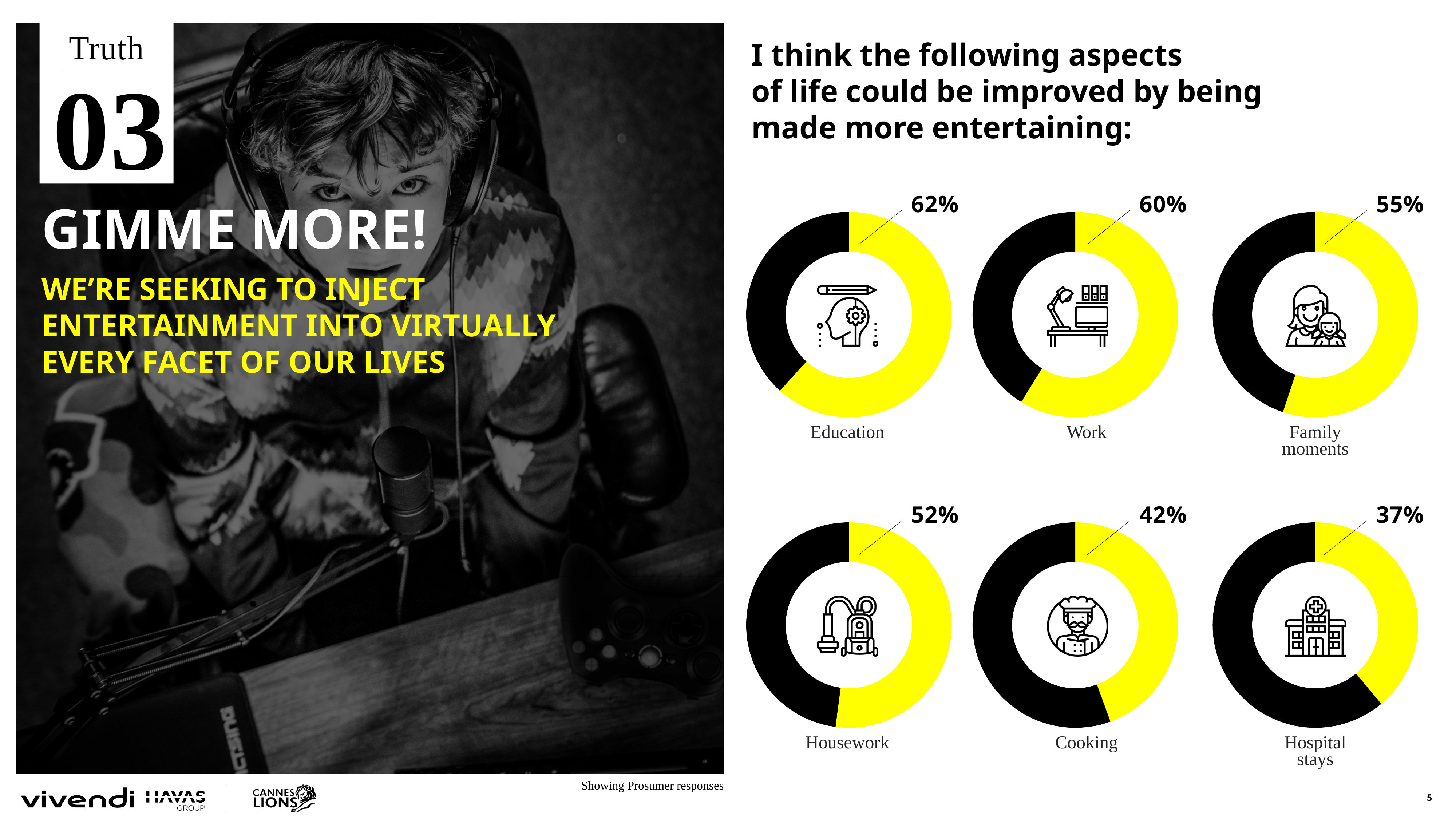
What percentage is shown for the Cooking donut chart? 42% What percentage is shown for the Work donut chart? 60% Which has a larger percentage, Housework or Cooking? Housework Which aspect of life has the highest percentage across the donut charts? Education How many donut charts are shown on the slide? 6 What is the difference between the Education percentage and the Hospital stays percentage? 25% Which aspect of life has the lowest percentage across the donut charts? Hospital stays What percentage is shown for the Family moments donut chart? 55% What percentage is shown for the Education donut chart? 62% What percentage is shown for the Housework donut chart? 52% What percentage is shown for the Hospital stays donut chart? 37% What kind of chart is used to show each aspect of life on the slide? Donut chart